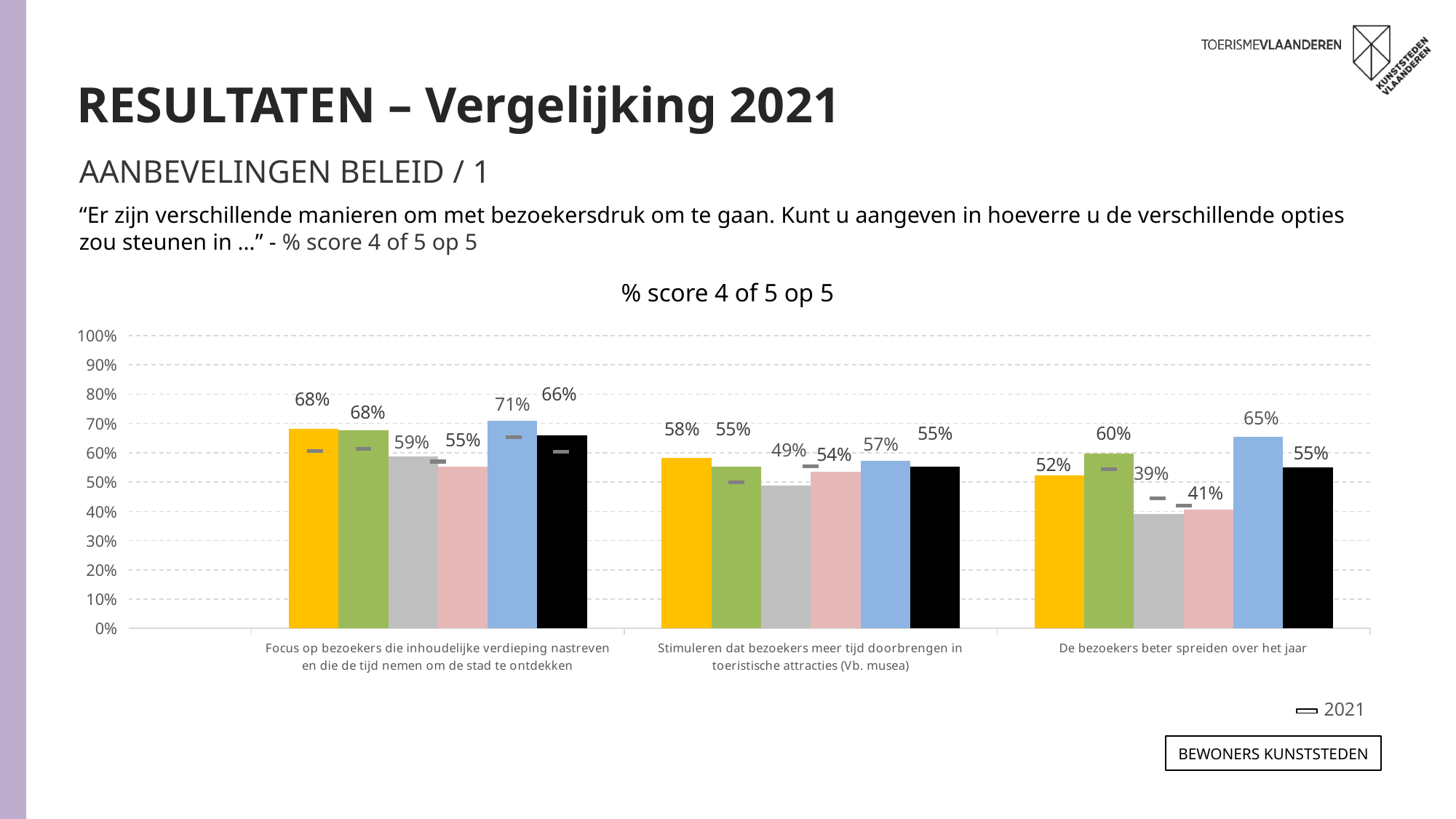
What is the value of the blue bar for 'De bezoekers beter spreiden over het jaar'? 65% What year does the legend marker at the bottom right of the chart refer to? 2021 What is the title of the chart? % score 4 of 5 op 5 For 'Stimuleren dat bezoekers meer tijd doorbrengen in toeristische attracties (Vb. musea)', which is larger: the yellow bar or the grey bar? the yellow bar What is the difference between the blue bar and the grey bar for 'De bezoekers beter spreiden over het jaar'? 26% What is the value of the yellow bar for 'Stimuleren dat bezoekers meer tijd doorbrengen in toeristische attracties (Vb. musea)'? 58% What is the value of the grey bar for 'De bezoekers beter spreiden over het jaar'? 39% What kind of chart is shown on the slide? bar chart Which bar has the highest value in the category 'Focus op bezoekers die inhoudelijke verdieping nastreven en die de tijd nemen om de stad te ontdekken'? the blue bar (71%) What is the value of the black bar for 'Focus op bezoekers die inhoudelijke verdieping nastreven en die de tijd nemen om de stad te ontdekken'? 66% Which bar has the lowest value in the category 'De bezoekers beter spreiden over het jaar'? the grey bar (39%) How many categories are shown on the x axis of the chart? 3